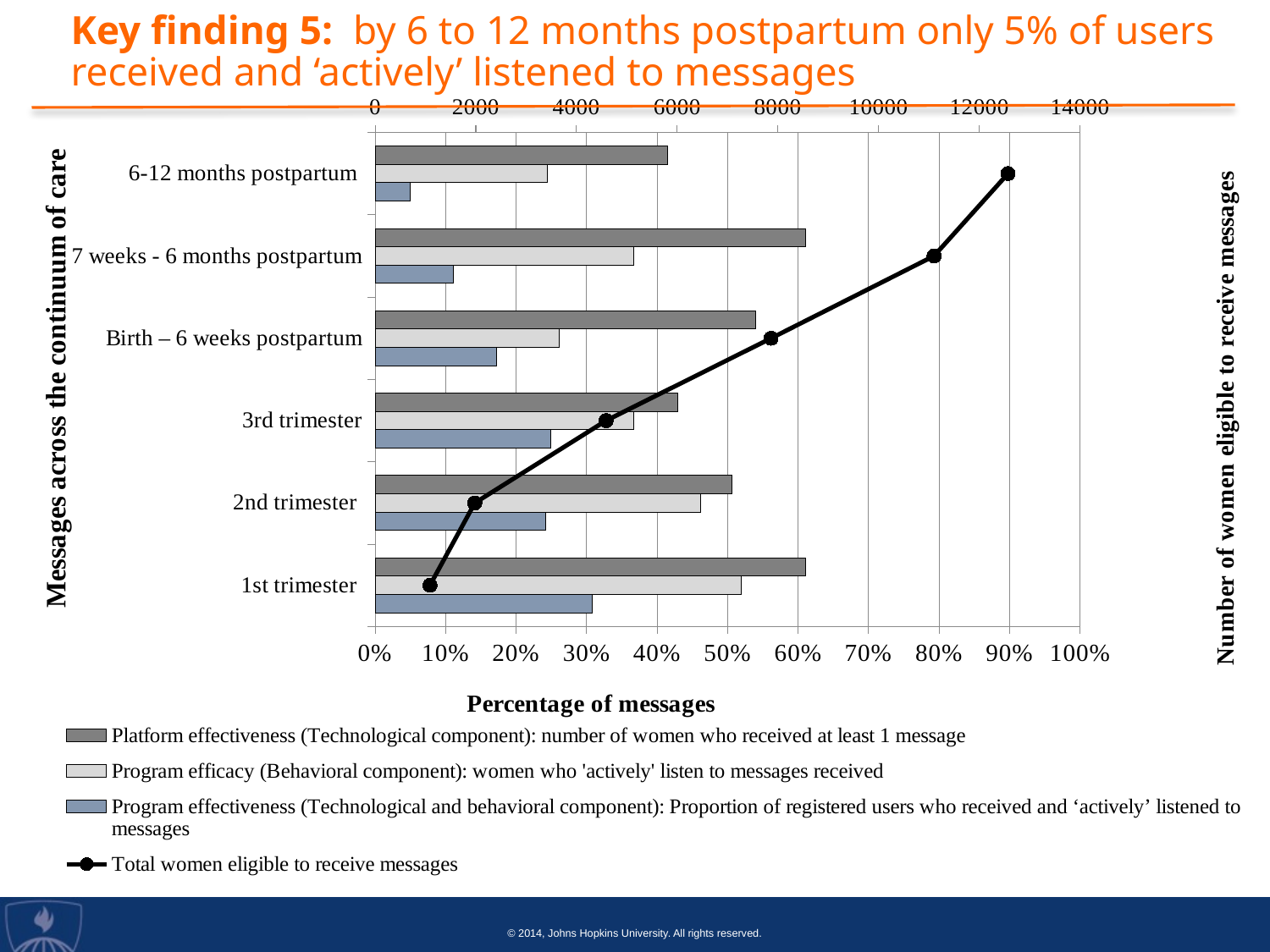
Is the Platform effectiveness value for 1st trimester greater or less than 50%? greater Is the Total women eligible to receive messages value for 1st trimester greater or less than 2000? less How many categories are shown on the vertical axis of the chart? 6 What kind of chart is shown on the slide? combination bar and line chart Is the Program effectiveness value for 6-12 months postpartum greater or less than 10%? less Which category has the highest Program effectiveness value? 1st trimester Which is larger, the Platform effectiveness value for 2nd trimester or for 3rd trimester? 2nd trimester Which category has the lowest Program effectiveness value? 6-12 months postpartum How many series does the legend list? 4 What is the title of the horizontal axis at the bottom of the chart? Percentage of messages Does the Total women eligible to receive messages line rise or fall from 1st trimester to 6-12 months postpartum? rise